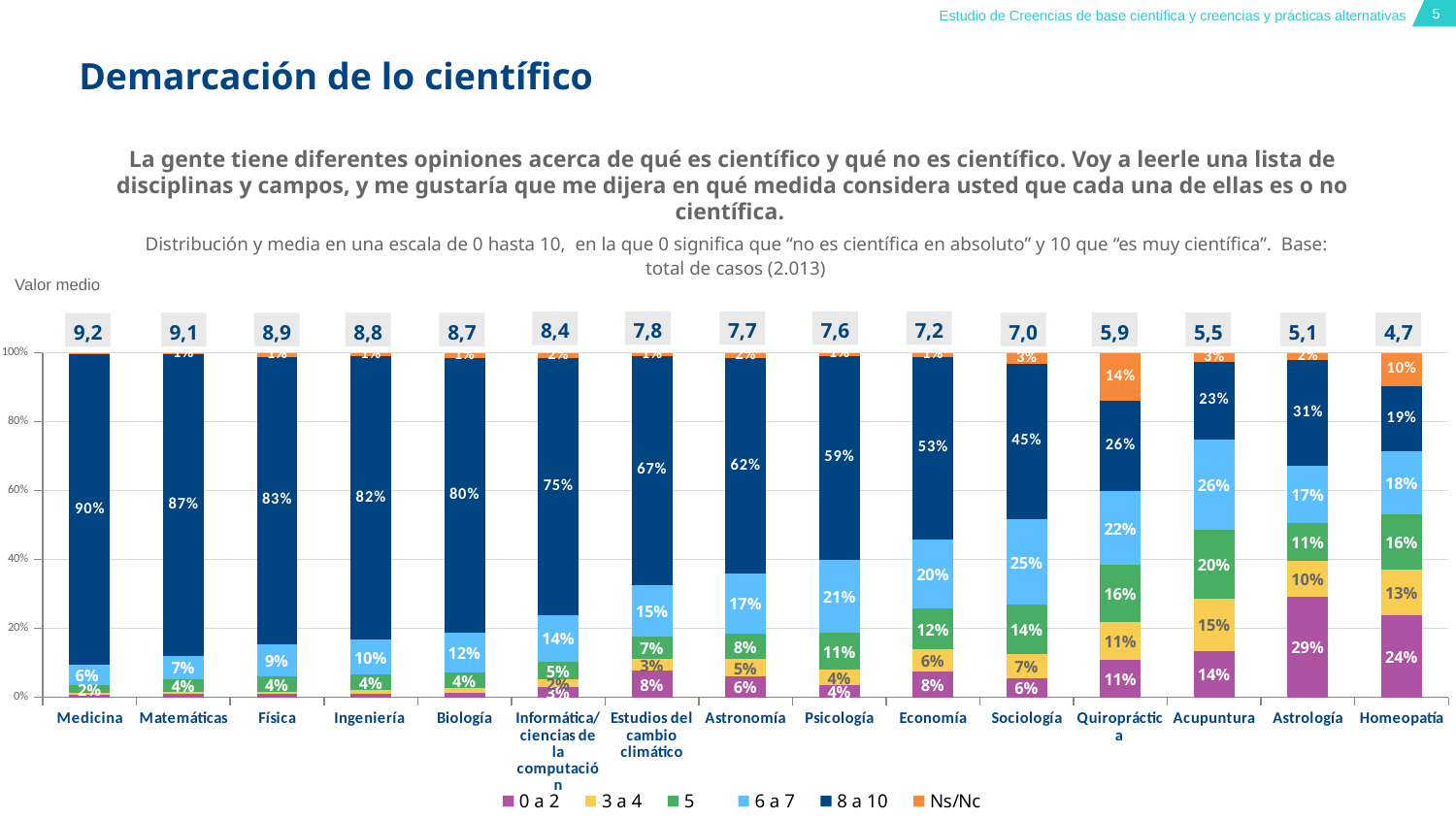
How many disciplines (categories) are shown along the x axis? 15 What is the '8 a 10' percentage for Medicina? 90% Which discipline has the lowest mean value (valor medio)? Homeopatía What is the '8 a 10' percentage for Homeopatía? 19% What type of chart is shown on the slide? stacked bar chart Which has a larger '0 a 2' percentage, Acupuntura or Economía? Acupuntura What is the difference between the '8 a 10' percentages for Matemáticas and Psicología? 28% What is the '0 a 2' percentage for Astrología? 29% How many series does the legend list? 6 What is the mean value (valor medio) shown above the bar for Física? 8,9 Which discipline has the highest '8 a 10' percentage? Medicina What is the Ns/Nc percentage for Quiropráctica? 14%